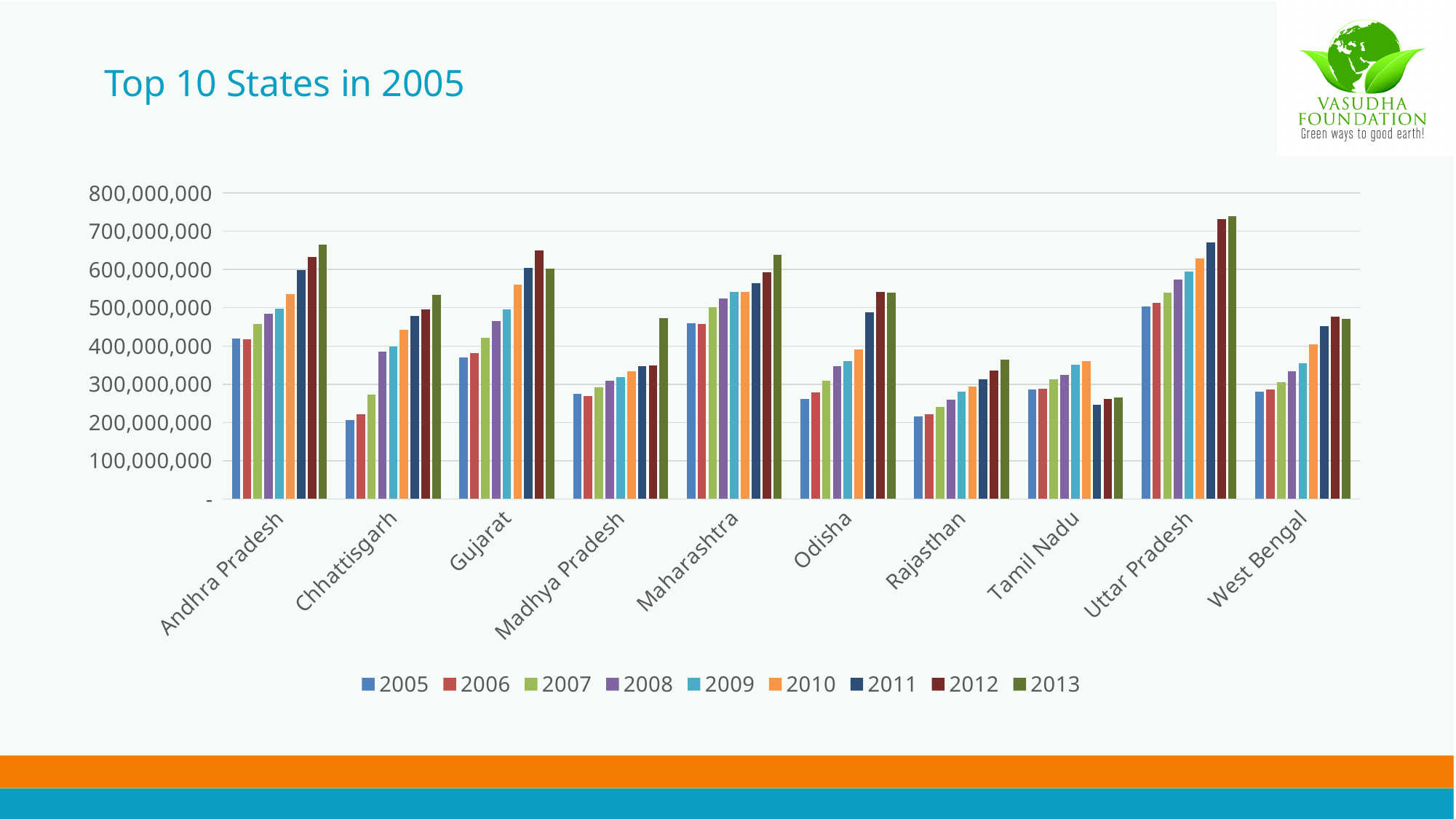
Which state has the lowest value for 2013? Tamil Nadu What kind of chart is shown on the slide? bar chart How many states are shown on the x axis of the chart? 10 Which state has the highest value for 2013? Uttar Pradesh Which state has the highest value for 2005? Uttar Pradesh How many series (years) does the legend list? 9 Is the value for Uttar Pradesh in 2013 greater or less than 700,000,000? greater What is the title of the chart? Top 10 States in 2005 For Gujarat, which is larger: the value for 2012 or the value for 2013? 2012 Is the value for Chhattisgarh in 2005 greater or less than 300,000,000? less Which is larger for 2005: Maharashtra or Odisha? Maharashtra Is the value for Andhra Pradesh in 2013 greater or less than 600,000,000? greater